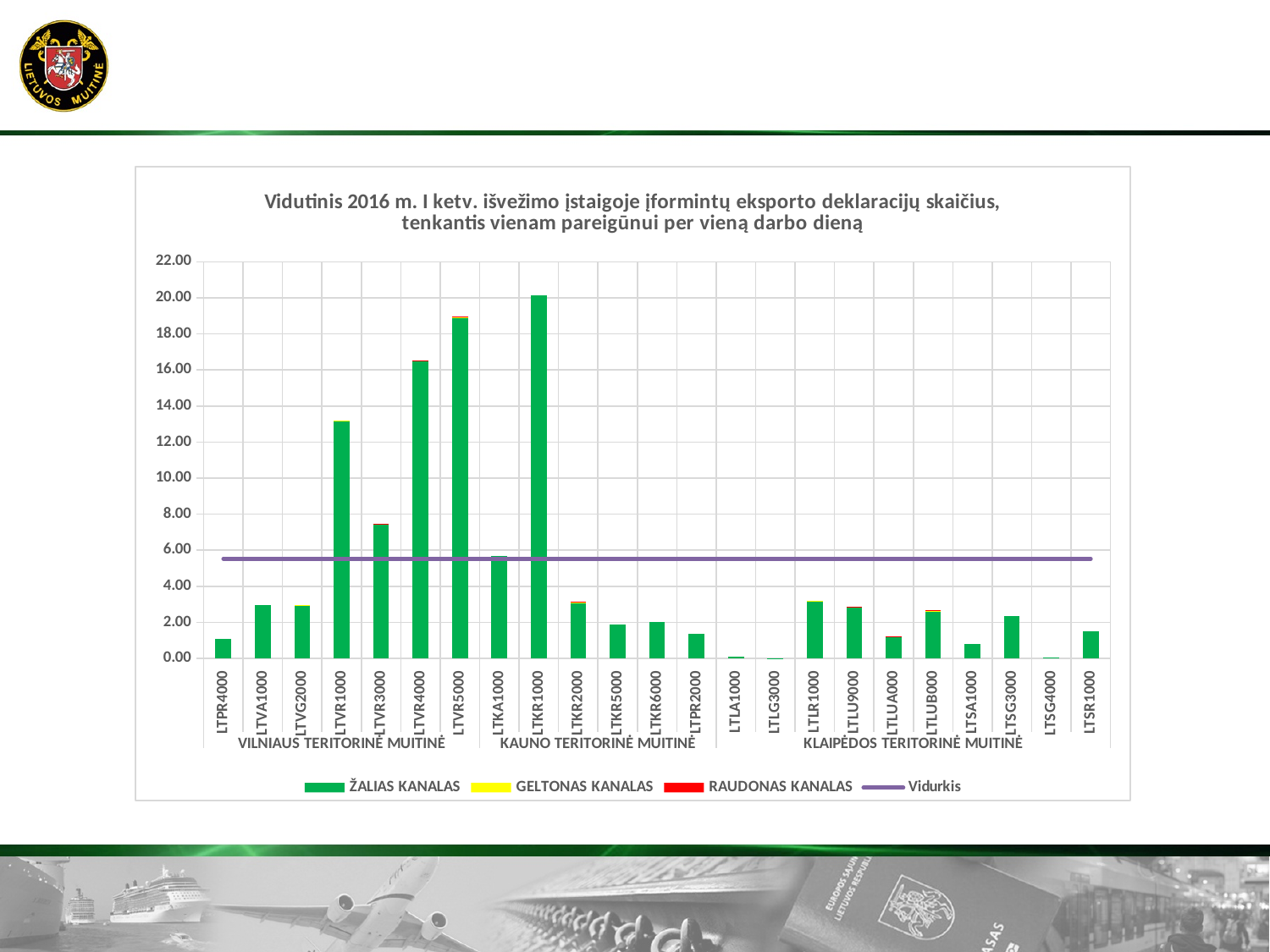
Which territorial customs office group contains the category LTKR1000? KAUNO TERITORINĖ MUITINĖ Is the value for LTVR1000 greater or less than 12.00? greater Is the value for LTKR5000 greater or less than 4.00? less Which is larger, the bar for LTVR4000 or the bar for LTVR3000? LTVR4000 Which legend entry is drawn as a purple line rather than bars? Vidurkis What kind of chart is shown on the slide? combination bar and line chart How many entries does the legend list? 4 Which category has the highest bar? LTKR1000 Is the value for LTVR5000 greater or less than 18.00? greater Which is larger, the bar for LTVR1000 or the bar for LTKA1000? LTVR1000 How many customs post categories are shown along the x axis? 23